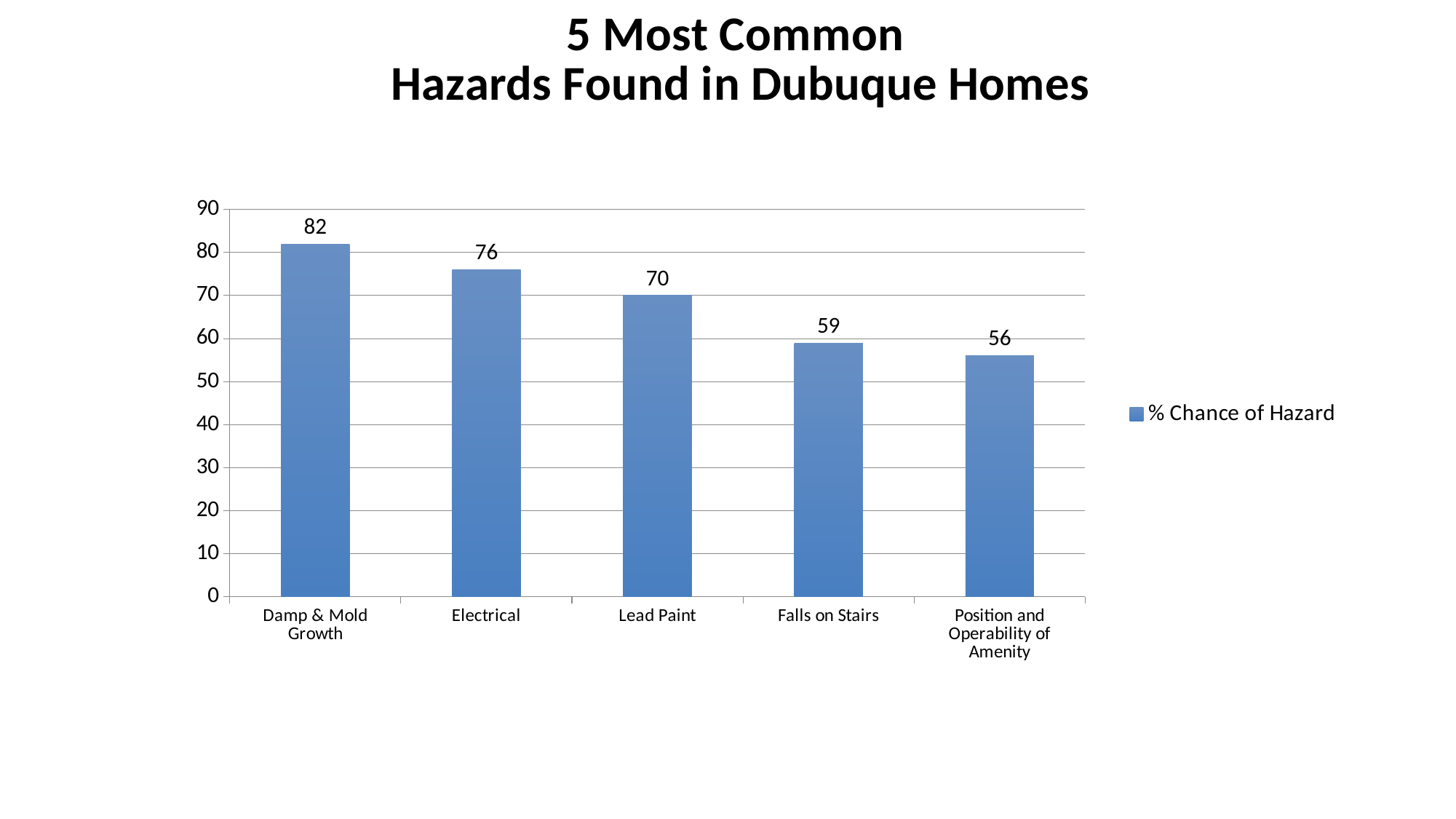
Which hazard has the lowest % Chance of Hazard? Position and Operability of Amenity Do the values rise or fall from left to right along the x axis? Fall Which has a higher % Chance of Hazard, Electrical or Lead Paint? Electrical How many hazard categories are shown on the chart? 5 What is the % Chance of Hazard for Electrical? 76 Which hazard has the highest % Chance of Hazard? Damp & Mold Growth What is the % Chance of Hazard for Position and Operability of Amenity? 56 What is the difference between the % Chance of Hazard for Damp & Mold Growth and Falls on Stairs? 23 What kind of chart is shown on the slide? Bar chart What is the % Chance of Hazard for Damp & Mold Growth? 82 What is the % Chance of Hazard for Lead Paint? 70 How many series does the legend list? 1